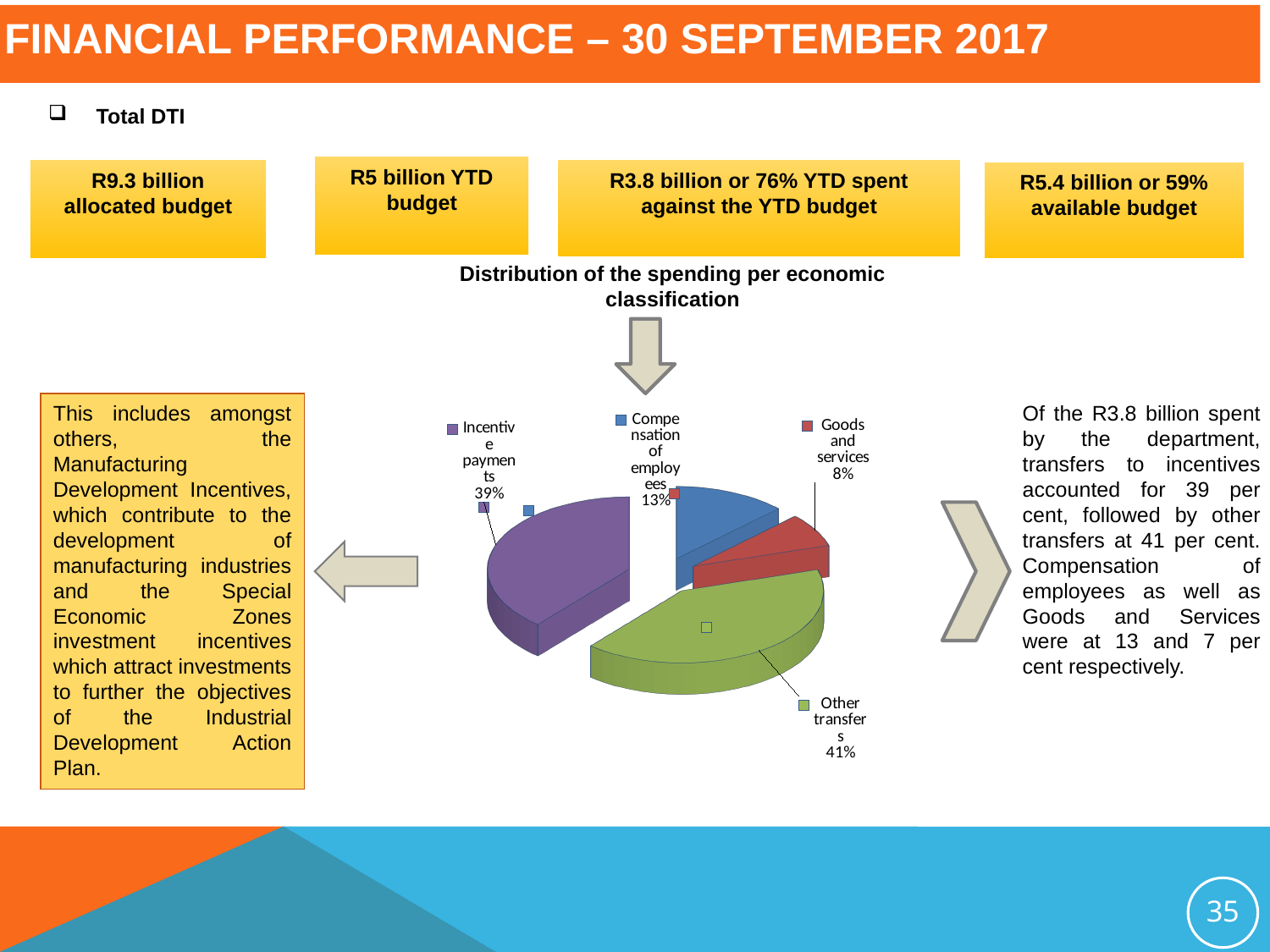
What is the difference in percentage points between Compensation of employees and Goods and services in the pie chart? 5 How many slices does the pie chart have? 4 What share of spending does the pie chart show for Compensation of employees? 13% What is the title of the pie chart? Distribution of the spending per economic classification What kind of chart is shown on the slide? pie chart What share of spending does the pie chart show for Incentive payments? 39% What share of spending does the pie chart show for Goods and services? 8% Which category has the smallest slice in the pie chart? Goods and services Which is larger in the pie chart, Compensation of employees or Goods and services? Compensation of employees What is the difference in percentage points between Other transfers and Incentive payments in the pie chart? 2 Which category has the largest slice in the pie chart? Other transfers